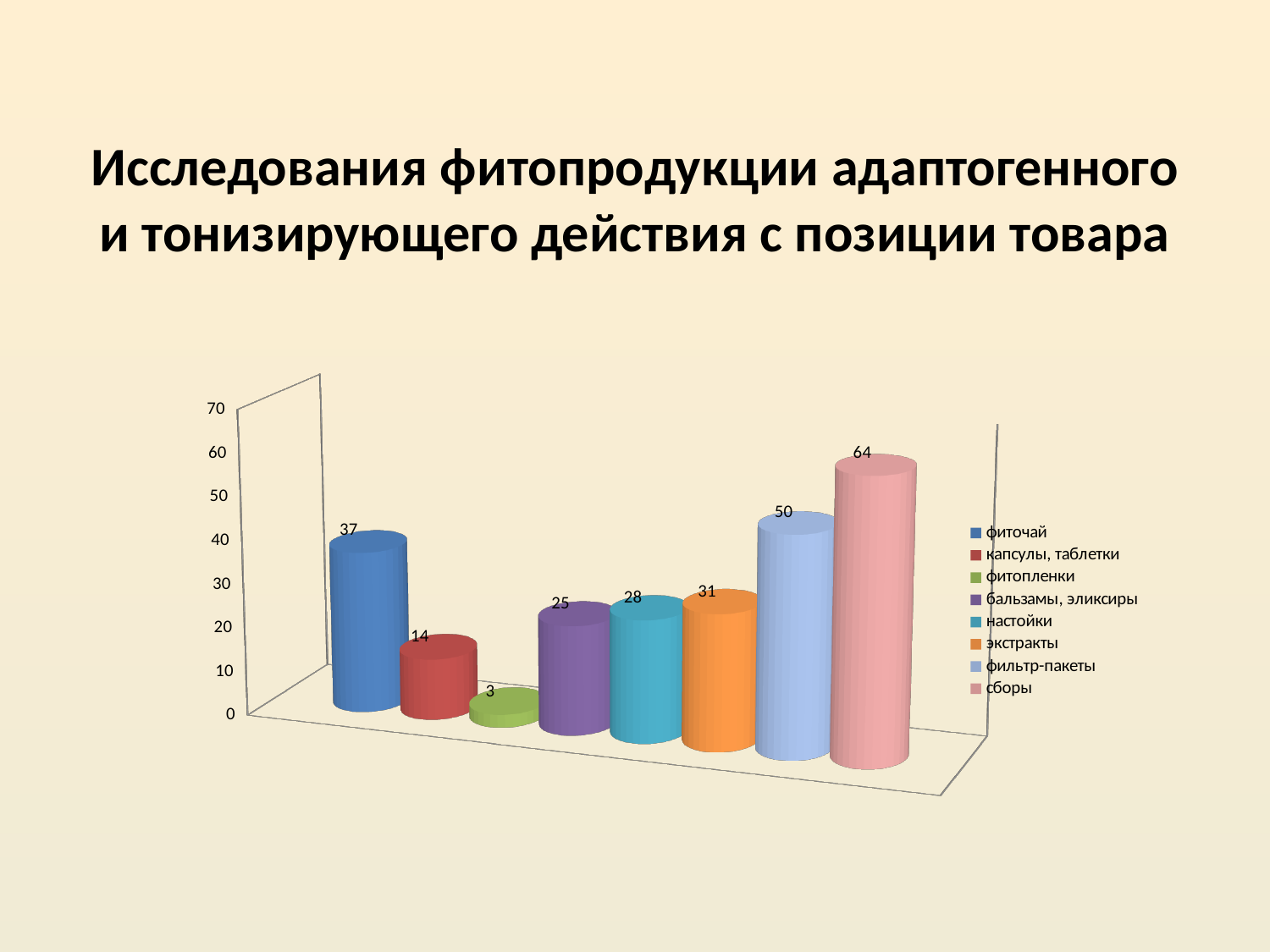
What is the difference between the values for фиточай and капсулы, таблетки? 23 How many categories are plotted in the chart? 8 How many entries does the legend list? 8 What is the value for настойки? 28 What kind of chart is shown on the slide? bar chart What is the difference between the values for сборы and фильтр-пакеты? 14 What is the value for фильтр-пакеты? 50 Which category has the highest value? сборы What is the value for фиточай? 37 Which category has the lowest value? фитопленки Which is larger, the value for экстракты or the value for бальзамы, эликсиры? экстракты What is the value for сборы? 64